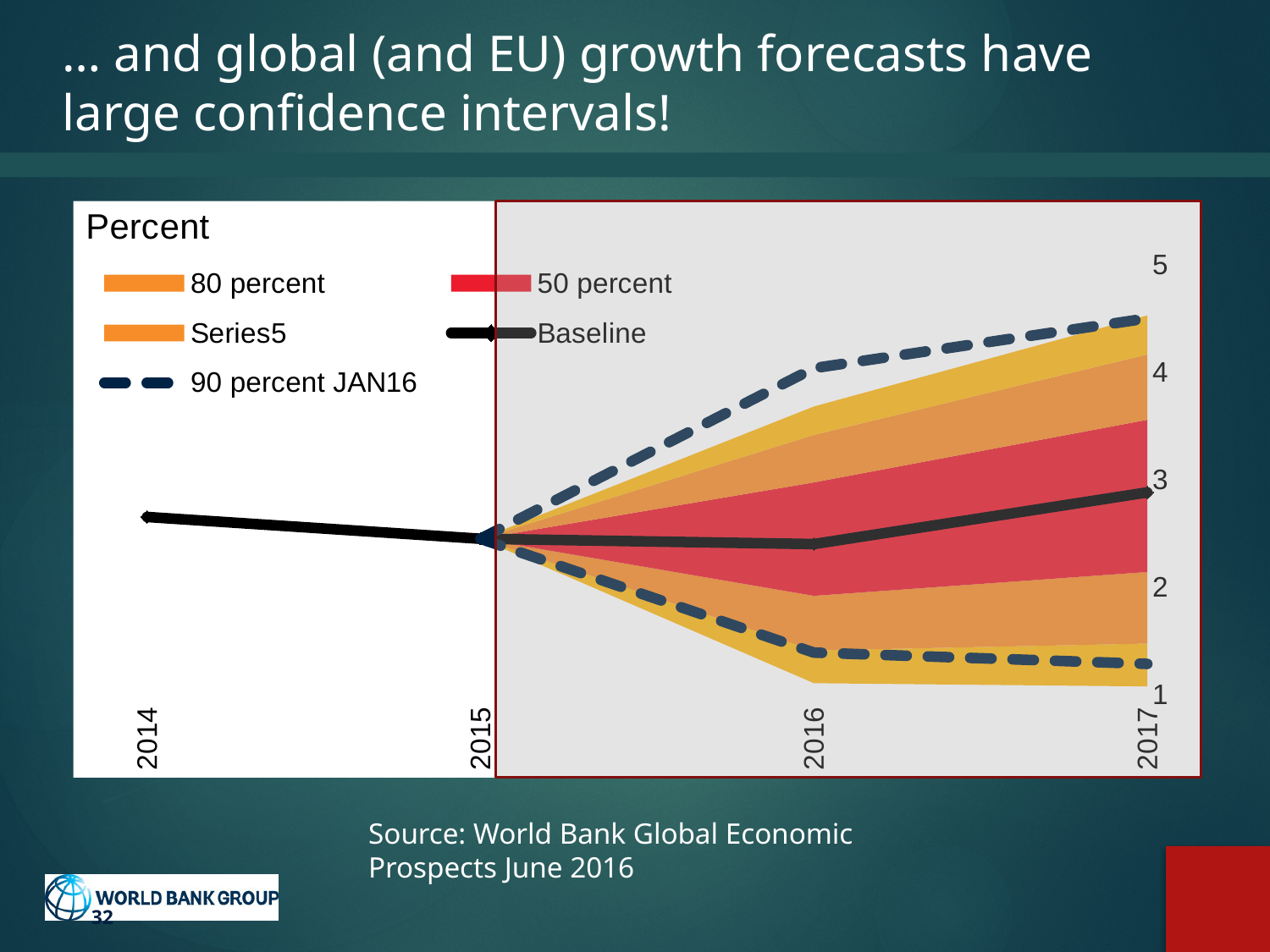
Is the lower 90 percent JAN16 dashed line in 2017 greater or less than 2? less Is the upper 90 percent JAN16 dashed line in 2017 greater or less than 4? greater What unit label is shown at the top left of the chart? Percent Which year has the lowest Baseline value? 2016 Is the lower 90 percent JAN16 dashed line in 2016 greater or less than 2? less How many years are labelled on the x axis? 4 Is the Baseline value higher in 2014 or in 2016? 2014 How many entries does the legend list? 5 Is the Baseline value higher in 2016 or in 2017? 2017 Does the Baseline rise or fall between 2014 and 2016? fall